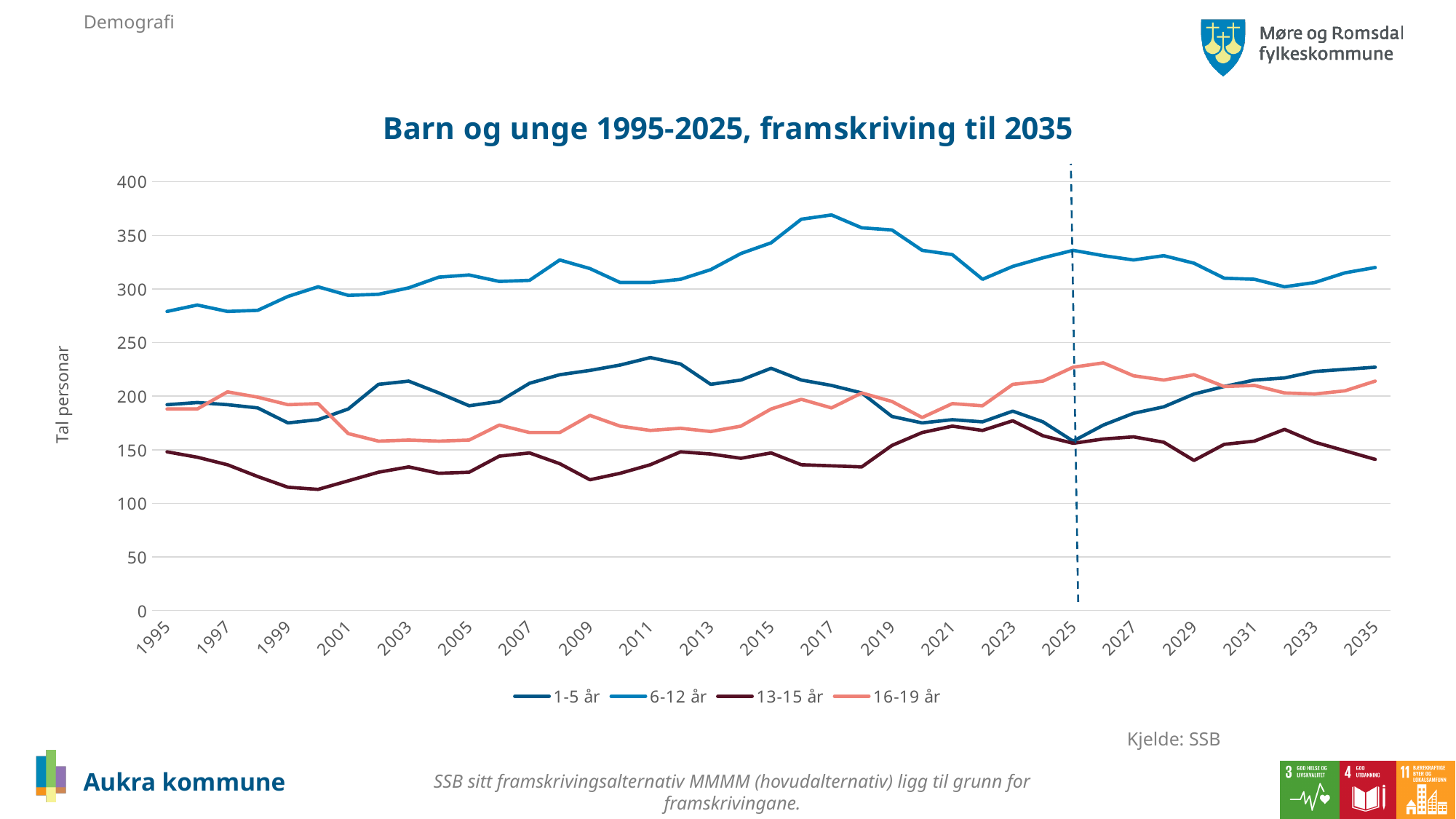
What kind of chart is shown on the slide? line chart Which age group has the highest values across the whole period shown? 6-12 år What is the title of the chart? Barn og unge 1995-2025, framskriving til 2035 Does the 6-12 år series generally rise or fall from 1995 to 2017? rise Is the value for 1-5 år in 2025 greater or less than 200? less How many series does the legend list? 4 In 2025, which is larger: the value for 16-19 år or the value for 1-5 år? 16-19 år What source is cited below the chart? Kjelde: SSB Which age group has the lowest value in 1995? 13-15 år Is the value for 6-12 år in 2017 greater or less than 350? greater Is the value for 13-15 år in 2000 greater or less than 150? less In 2011, which is larger: the value for 1-5 år or the value for 16-19 år? 1-5 år